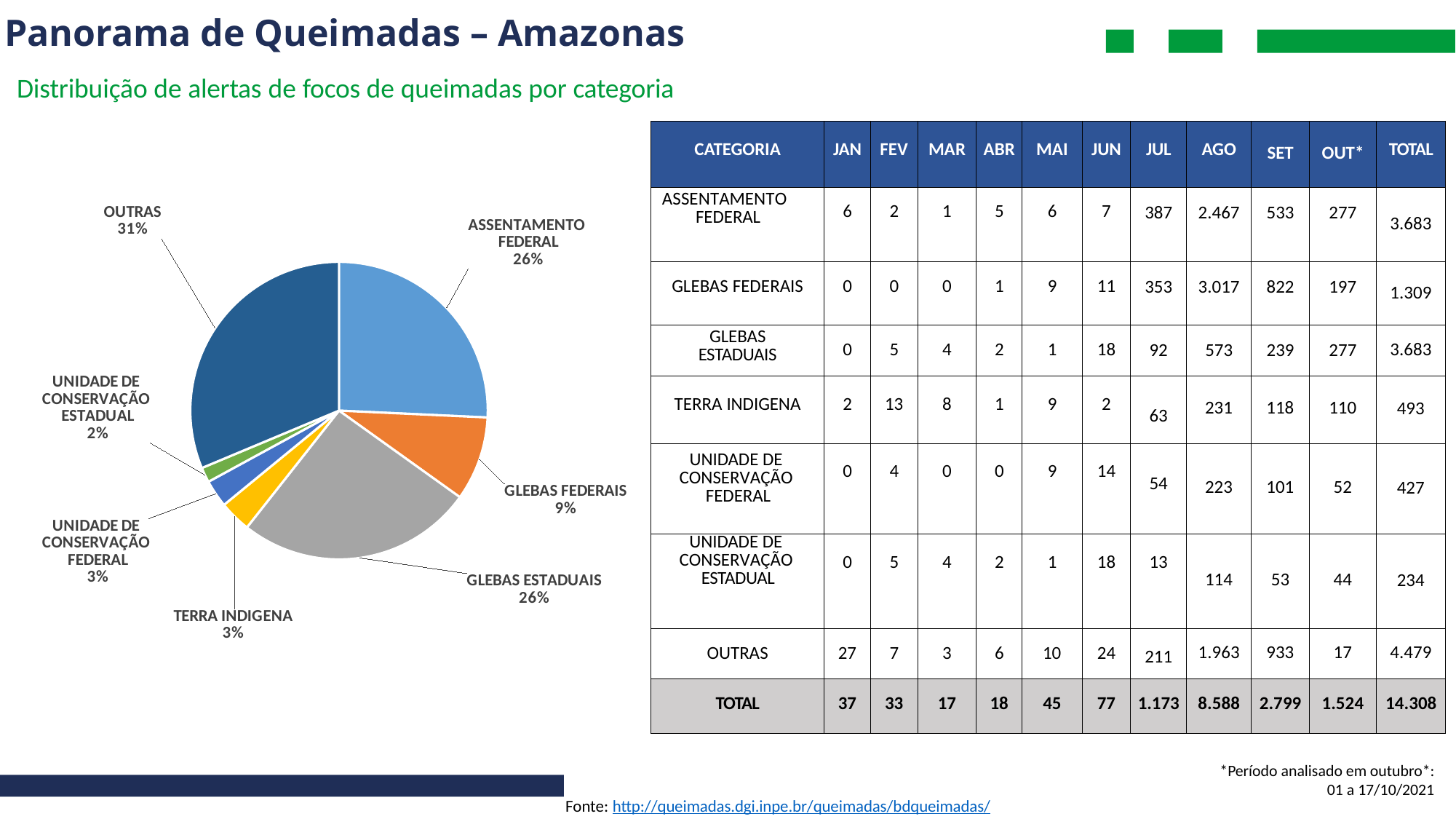
How many slices does the pie chart have? 7 Which category has the smallest slice in the pie chart? UNIDADE DE CONSERVAÇÃO ESTADUAL What is the subtitle shown above the pie chart? Distribuição de alertas de focos de queimadas por categoria In the pie chart, what is the difference in percentage points between OUTRAS and GLEBAS FEDERAIS? 22 percentage points What share of the pie chart does UNIDADE DE CONSERVAÇÃO ESTADUAL represent? 2% What kind of chart is shown on the left of the slide? pie chart Which category has the largest slice in the pie chart? OUTRAS What share of the pie chart does GLEBAS FEDERAIS represent? 9% What share of the pie chart does TERRA INDIGENA represent? 3% In the pie chart, which is larger: ASSENTAMENTO FEDERAL or GLEBAS FEDERAIS? ASSENTAMENTO FEDERAL